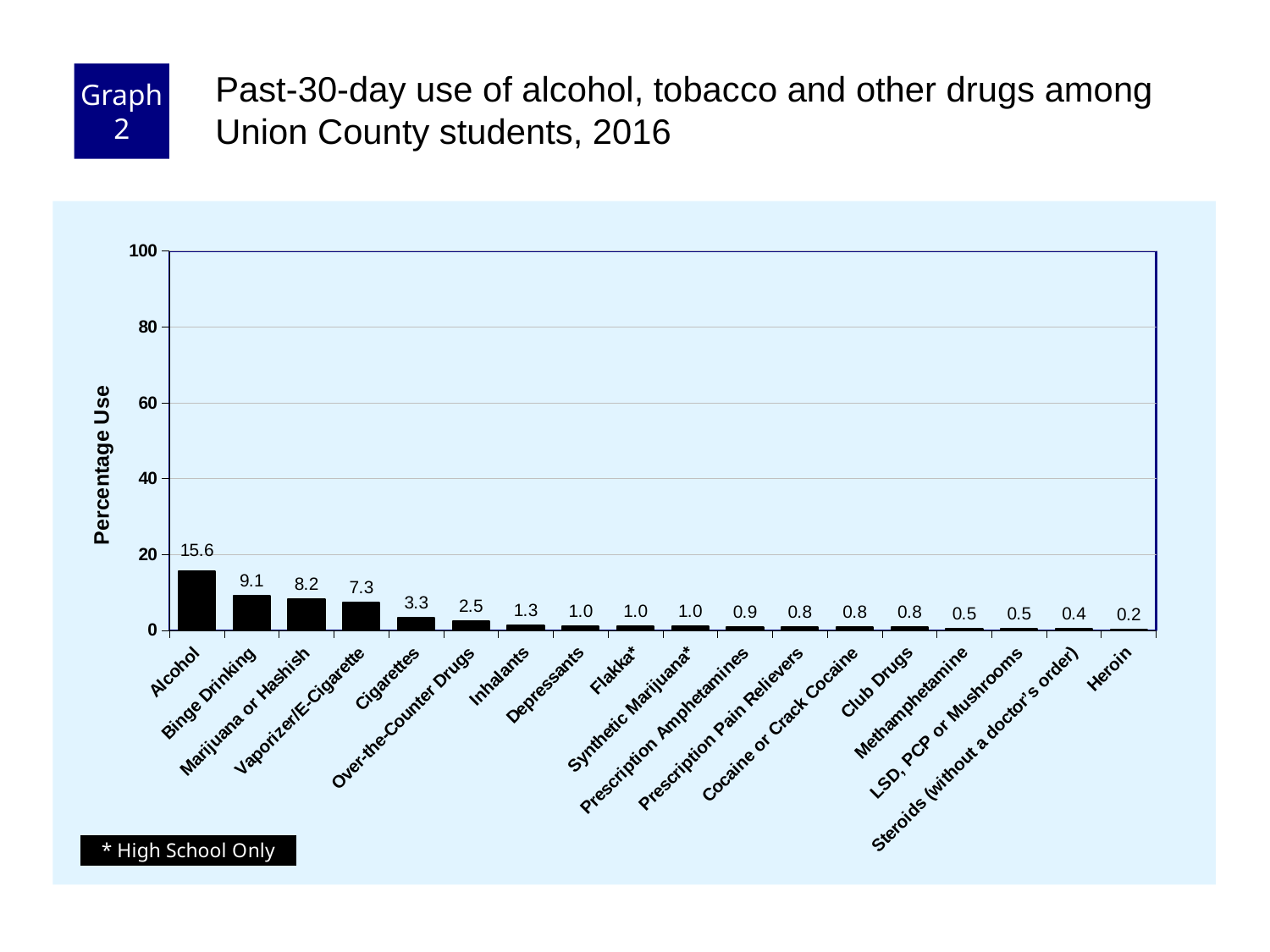
Is the value for Alcohol greater or less than 20? less Which category has the highest percentage use? Alcohol What is the percentage use for Cigarettes? 3.3 What kind of chart is shown on the slide? Bar chart What is the difference in percentage use between Alcohol and Binge Drinking? 6.5 Which has a higher percentage use, Over-the-Counter Drugs or Inhalants? Over-the-Counter Drugs What is the percentage use for Heroin? 0.2 What is the percentage use for Vaporizer/E-Cigarette? 7.3 How many categories are shown on the x axis? 18 What is the percentage use for Alcohol? 15.6 Which category has the lowest percentage use? Heroin What is the difference in percentage use between Marijuana or Hashish and Cigarettes? 4.9